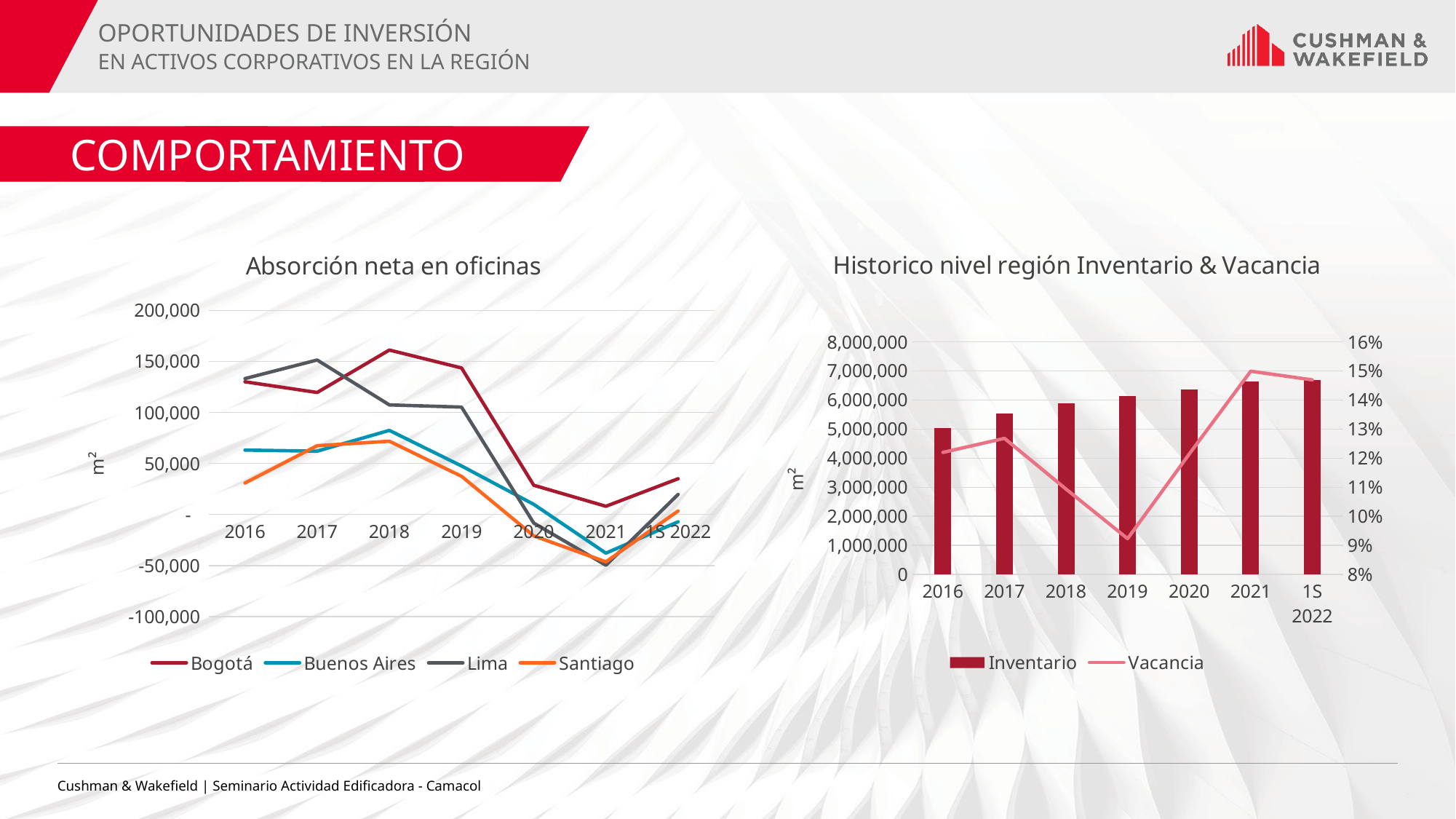
In the 'Absorción neta en oficinas' chart, in which year does the Bogotá series reach its highest value? 2018 In the 'Absorción neta en oficinas' chart, is the value for Santiago in 2016 greater or less than 50,000? less How many series does the legend of the 'Absorción neta en oficinas' chart list? 4 How many time periods are shown on the x axis of the 'Historico nivel región Inventario & Vacancia' chart? 7 In the 'Absorción neta en oficinas' chart, which is larger in 2019: Bogotá or Buenos Aires? Bogotá In the 'Historico nivel región Inventario & Vacancia' chart, is the Vacancia value for 2019 greater or less than 10%? less In the 'Historico nivel región Inventario & Vacancia' chart, which year has the lowest Inventario bar? 2016 What type of chart is the 'Absorción neta en oficinas' chart? line chart In the 'Historico nivel región Inventario & Vacancia' chart, in which year is Vacancia at its lowest? 2019 In the 'Historico nivel región Inventario & Vacancia' chart, does the Inventario series rise or fall from 2016 to 2021? rise In the 'Absorción neta en oficinas' chart, in which year does the Santiago series reach its lowest value? 2021 In the 'Absorción neta en oficinas' chart, is the value for Bogotá in 2018 greater or less than 150,000? greater